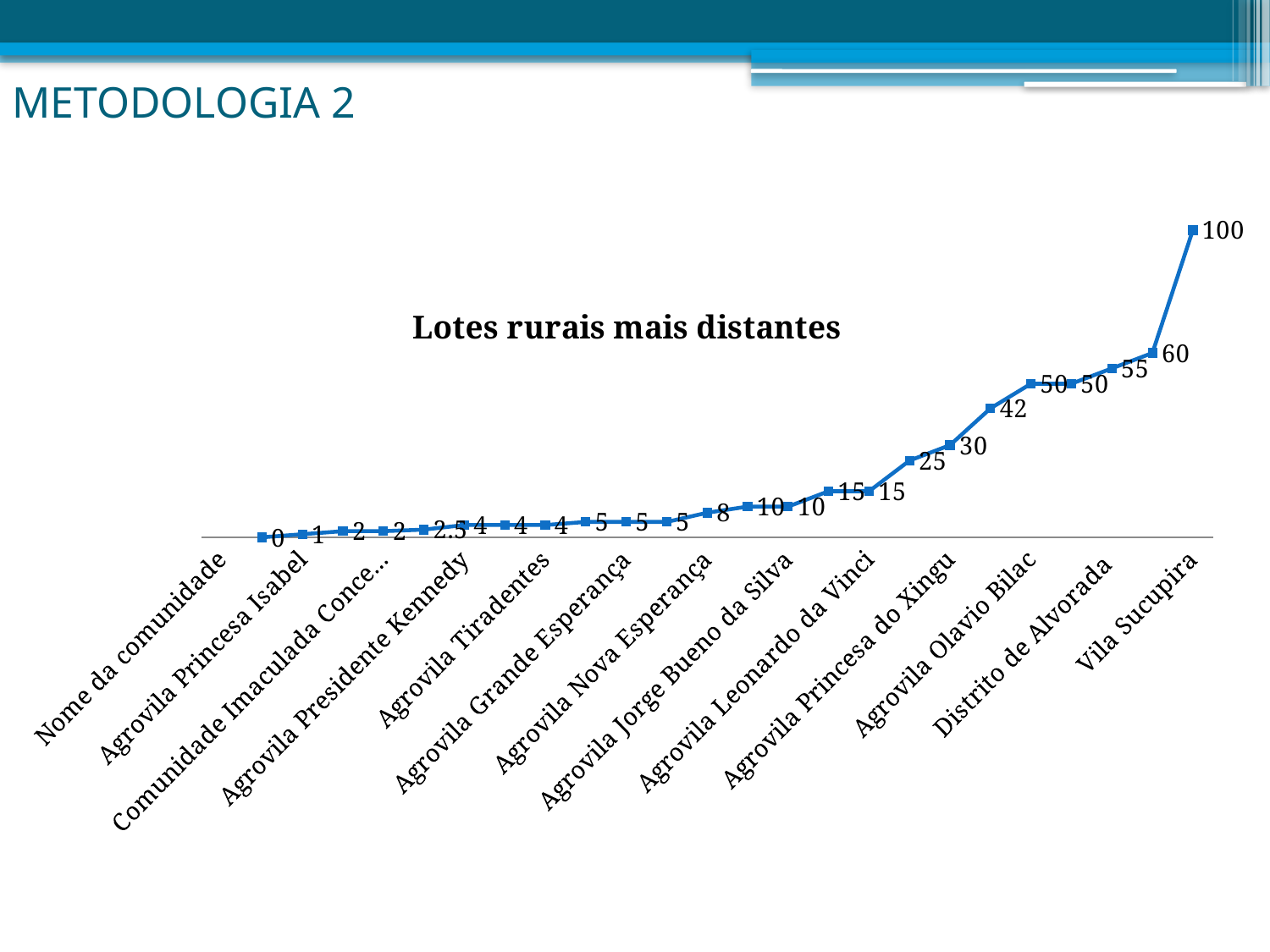
What is the lowest value plotted in the chart? 0 Which category has the highest value in the chart? Vila Sucupira Do the values generally rise or fall from left to right along the x axis? rise What is the value plotted for Vila Sucupira? 100 How many data points have the value 50? 2 What kind of chart is shown on the slide? line chart What is the title of the chart? Lotes rurais mais distantes What is the second highest value plotted in the chart? 60 How many data points are plotted on the line? 24 What is the difference between the highest value (100) and the second highest value (60)? 40